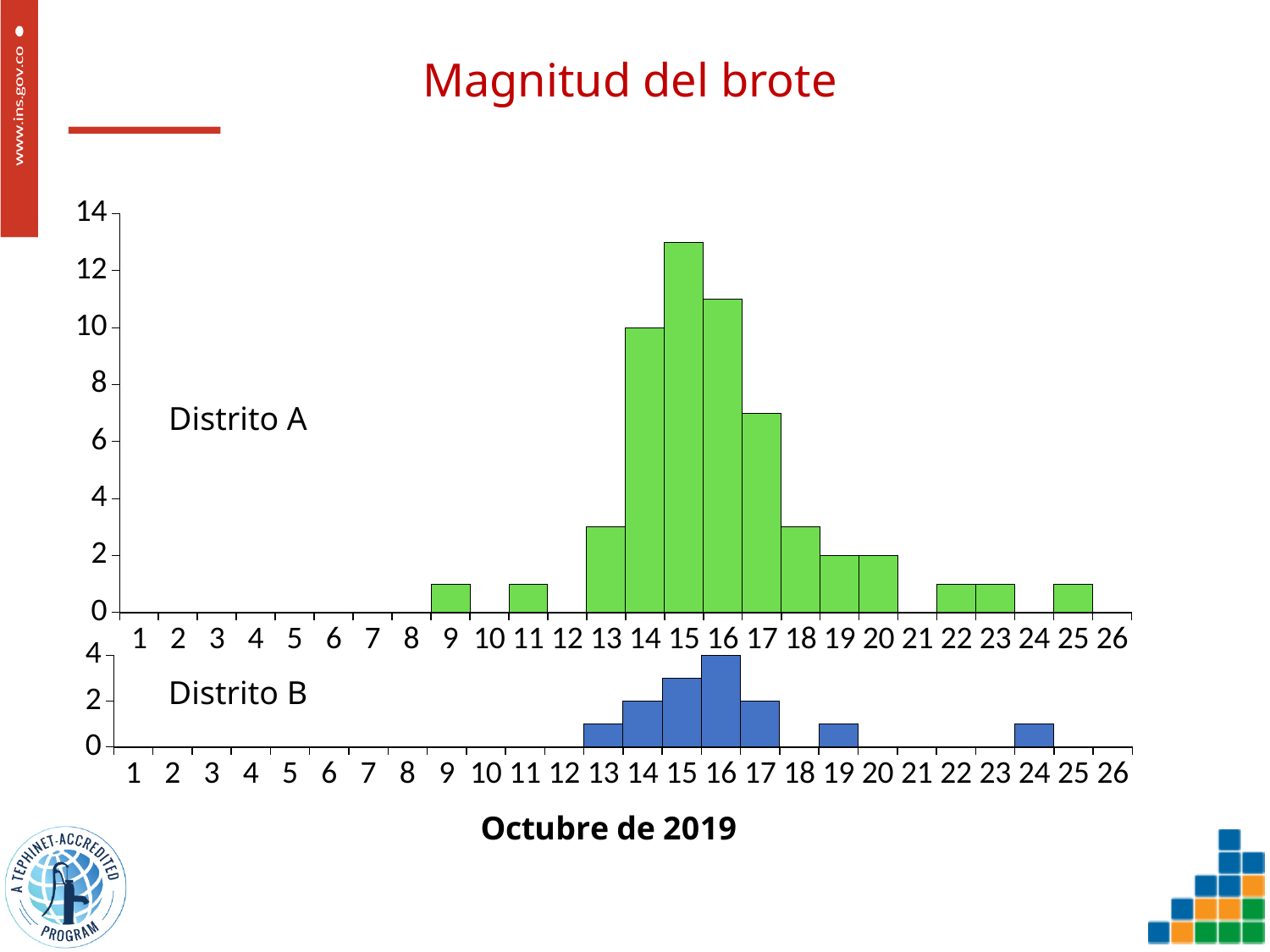
How many days are labelled on the x axis of the Distrito B chart? 26 In the Distrito A chart, what is the difference between the value for day 14 and the value for day 19? 8 What is the label shown below the x axis of the charts? Octubre de 2019 In the Distrito A chart, which is larger, the value for day 14 or the value for day 17? day 14 In the Distrito B chart, on which day of October is the value highest? 16 In the Distrito A chart, what is the value for day 14? 10 In the Distrito A chart, on which day of October is the value highest? 15 What kind of chart is used for Distrito A? bar chart In the Distrito A chart, is the value for day 15 greater or less than 12? greater In the Distrito A chart, is the value for day 17 greater or less than 8? less In the Distrito B chart, what is the value for day 14? 2 In the Distrito B chart, what is the value for day 16? 4